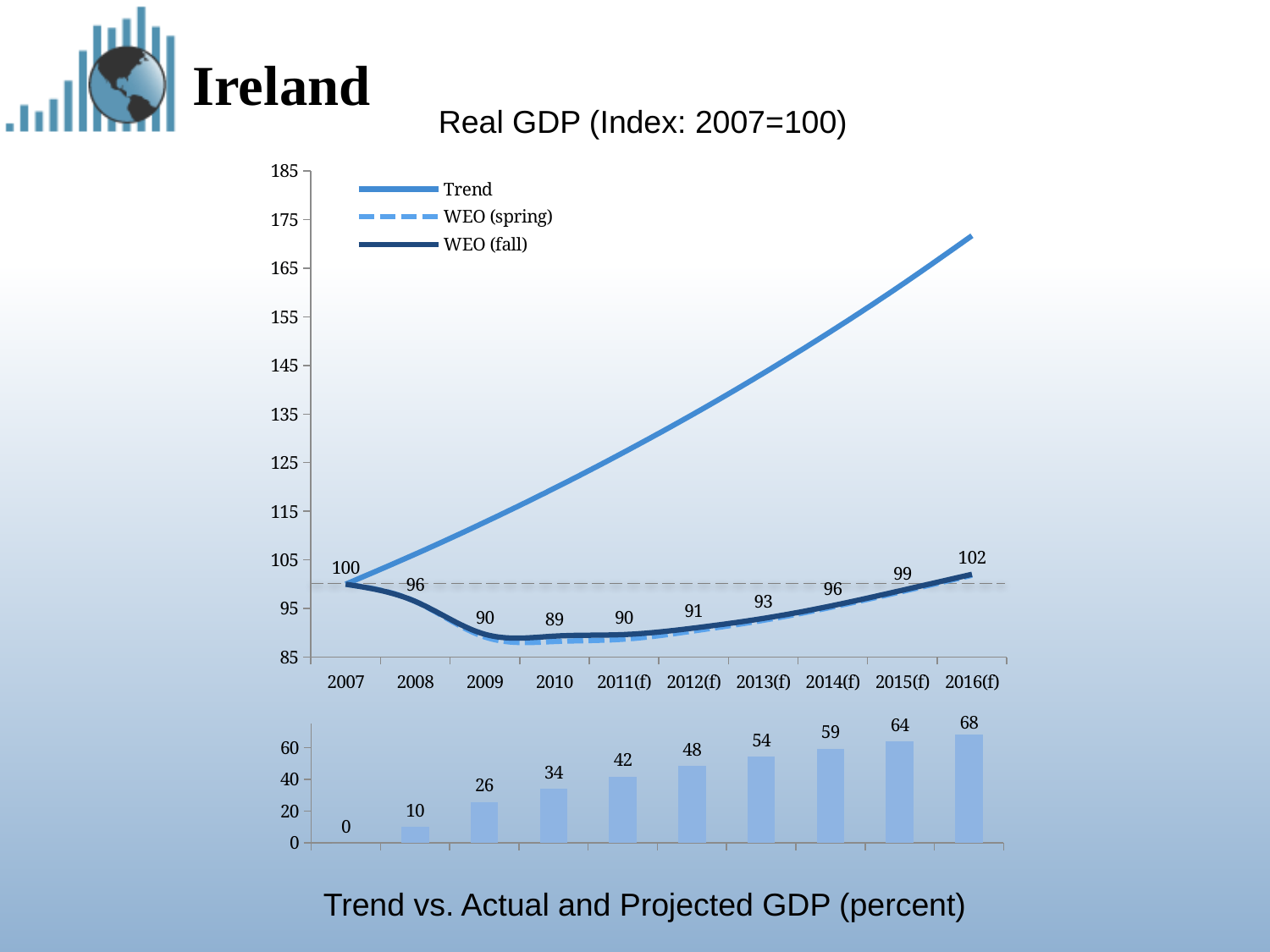
In the Real GDP (Index: 2007=100) chart, what is the difference between the labelled values for 2007 and 2009? 10 In the bottom chart, Trend vs. Actual and Projected GDP (percent), what is the value of the last bar? 68 In the Real GDP (Index: 2007=100) chart, how many years are shown on the x axis? 10 In the Real GDP (Index: 2007=100) chart, how many series does the legend list? 3 In the bottom chart, Trend vs. Actual and Projected GDP (percent), do the bar values rise or fall from left to right? rise In the Real GDP (Index: 2007=100) chart, what is the labelled value for 2010? 89 In the Real GDP (Index: 2007=100) chart, is the Trend value for 2012(f) greater or less than 125? greater In the Real GDP (Index: 2007=100) chart, is the Trend value for 2016(f) greater or less than 165? greater In the Real GDP (Index: 2007=100) chart, what is the labelled value for 2016(f)? 102 In the bottom chart, Trend vs. Actual and Projected GDP (percent), what is the difference between the fourth bar (34) and the seventh bar (54)? 20 In the Real GDP (Index: 2007=100) chart, which year has the lowest labelled value? 2010 What kind of chart is the bottom chart, Trend vs. Actual and Projected GDP (percent)? bar chart